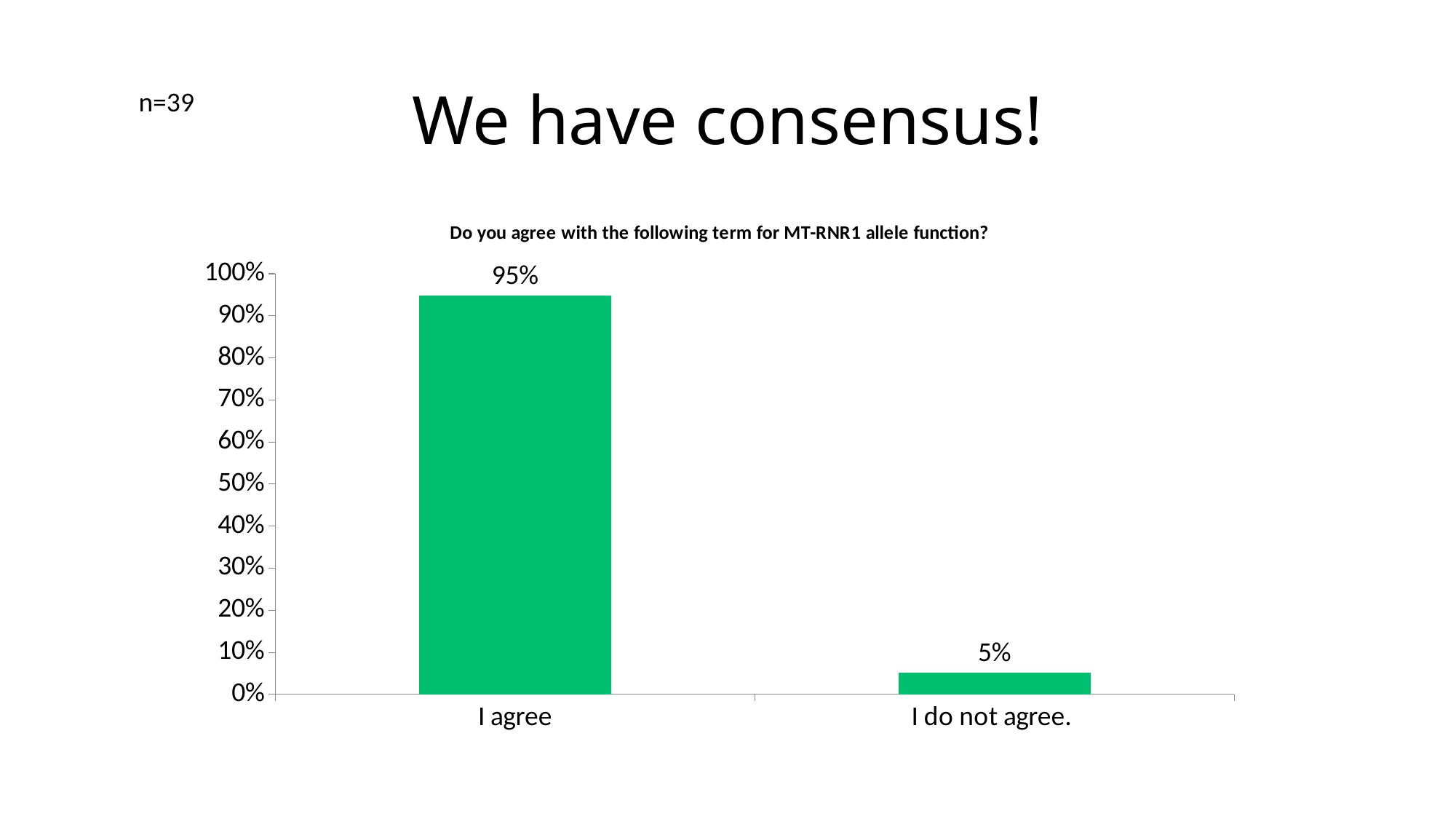
Which category has the lowest value? I do not agree. What percentage of respondents chose "I do not agree."? 5% Which category has the highest value? I agree Is the value for "I agree" greater or less than 50%? greater How many categories are shown on the x axis? 2 Which is larger, the value for "I agree" or the value for "I do not agree."? I agree What percentage of respondents chose "I agree"? 95% What is the title of the chart? Do you agree with the following term for MT-RNR1 allele function? What is the sample size (n) shown on the slide? n=39 What is the difference in percentage points between "I agree" and "I do not agree."? 90 Is the value for "I do not agree." greater or less than 10%? less What kind of chart is shown on the slide? bar chart